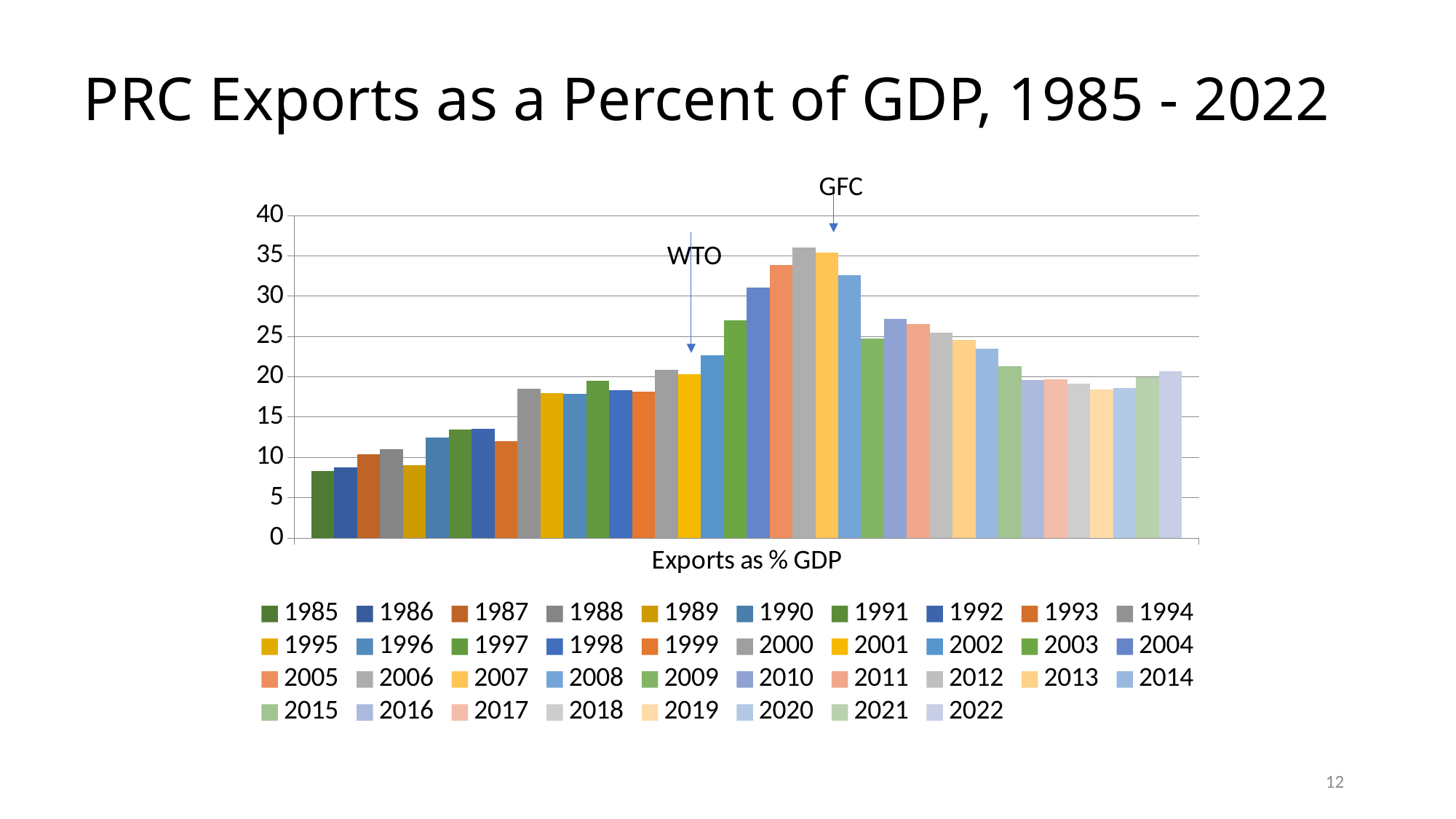
Do the values rise or fall from 2008 to 2014? fall Is the value for 2004 greater or less than 30? greater Is the value for 1985 greater or less than 10? less Which is larger, the value for 2005 or the value for 2008? 2005 What kind of chart is shown on the slide? bar chart What two events are annotated with arrows on the chart? WTO and GFC Is the value for 2006 greater or less than 35? greater Which year has the highest exports as a percent of GDP? 2006 How many series does the legend list? 38 Which year has the lowest exports as a percent of GDP? 1985 Which is larger, the value for 2004 or the value for 2009? 2004